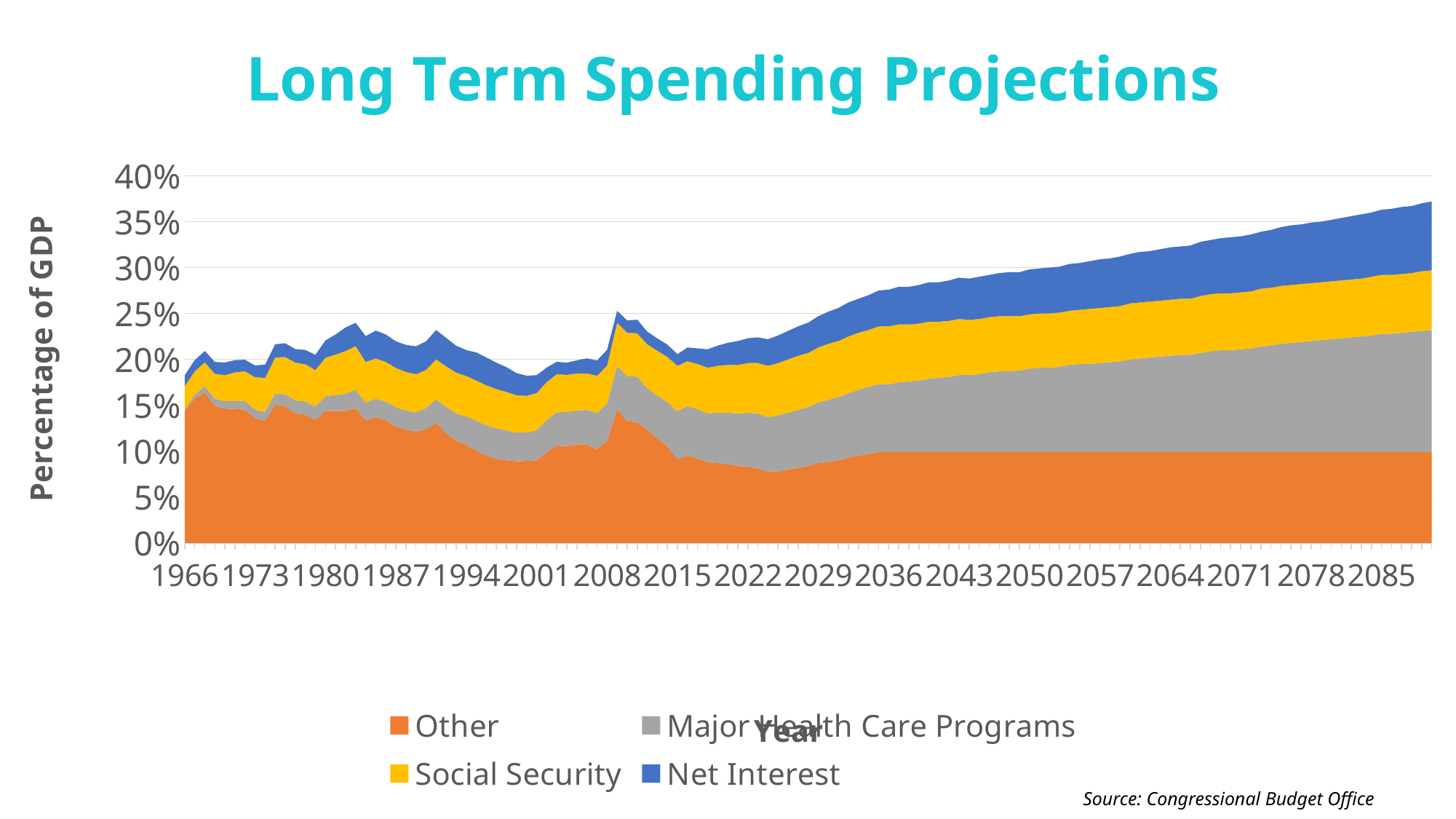
Is the total spending value in 1966 greater or less than 20%? less Is the total spending value in 2036 greater or less than 25%? greater Is the total spending value in 2085 greater or less than the total in 1966? greater Is the value for the Other series in 2050 greater or less than 15%? less Which series forms the bottom layer of the stacked area? Other What is the label on the vertical axis? Percentage of GDP What kind of chart is shown on the slide? Stacked area chart How many series does the legend list? 4 What is the title of the chart? Long Term Spending Projections Does total spending as a percentage of GDP rise or fall from 2022 to 2085? rise